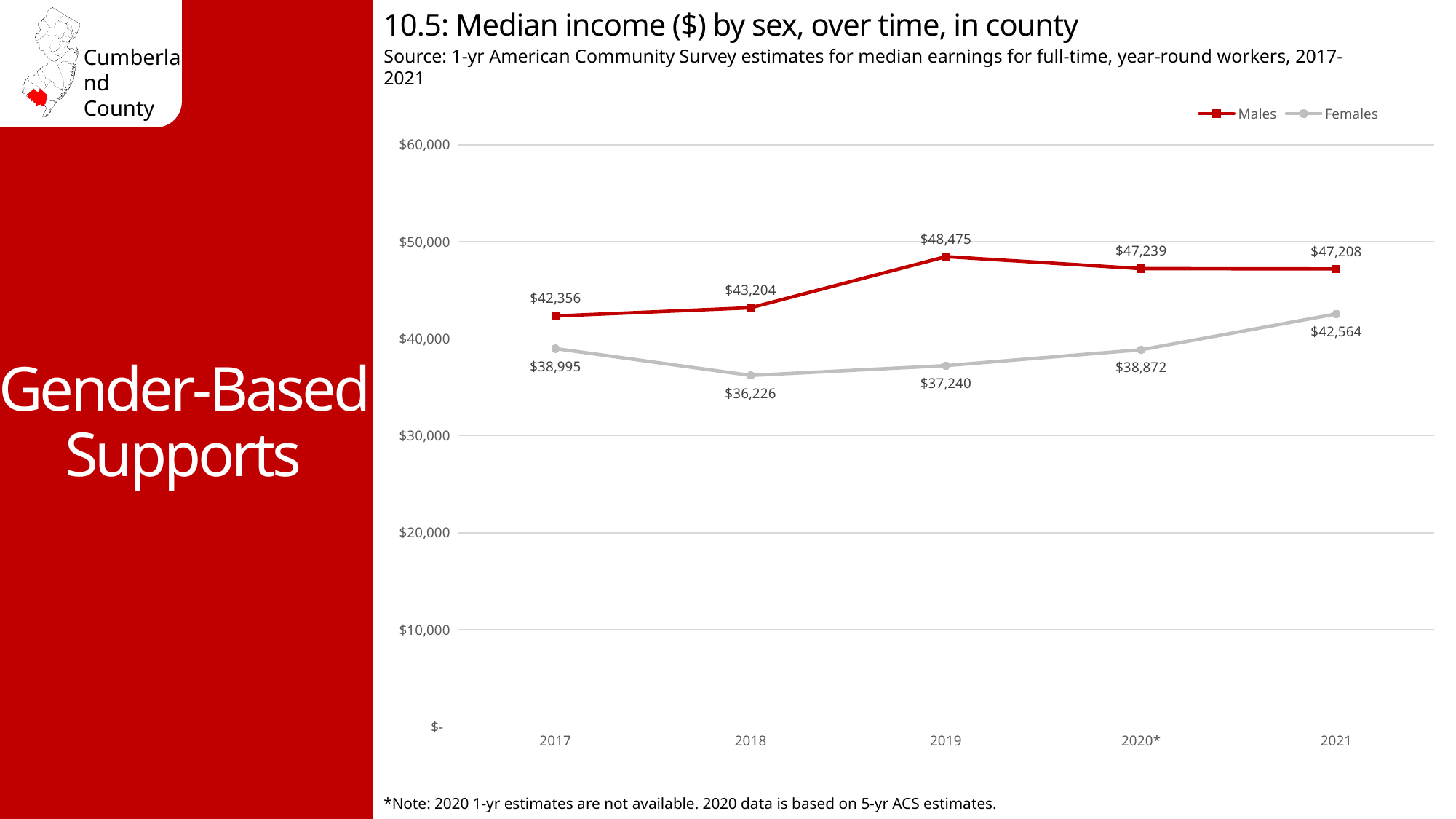
What is the difference between the Males and Females median income in 2021? $4,644 In which year was the median income for Females lowest? 2018 What was the median income for Females in 2018? $36,226 In which year was the median income for Males highest? 2019 How many series does the legend list? 2 Is the median income for Females in 2020* greater or less than $40,000? less How many years are shown on the x axis? 5 What is the difference between the Males median income in 2019 and in 2018? $5,271 What was the median income for Females in 2021? $42,564 What was the median income for Males in 2019? $48,475 Which series had the higher median income in 2017, Males or Females? Males What kind of chart is shown on the slide? line chart